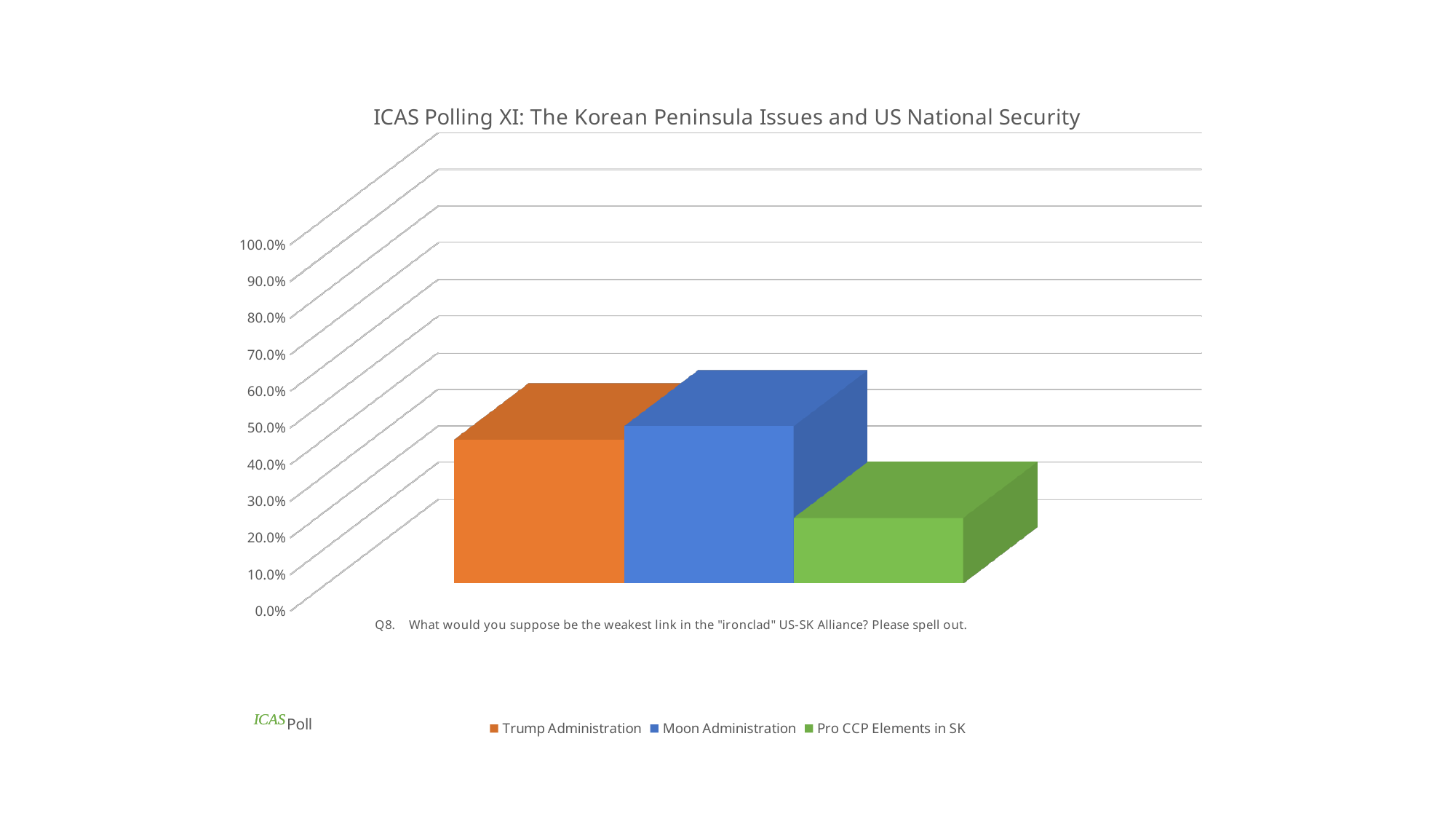
What is the title of the chart? ICAS Polling XI: The Korean Peninsula Issues and US National Security How many series does the legend list? 3 What kind of chart is shown on the slide? bar chart Which series has the lowest value? Pro CCP Elements in SK Is the value for Pro CCP Elements in SK greater or less than 30.0%? less Is the value for Trump Administration greater or less than 20.0%? greater Which is larger, the value for Trump Administration or the value for Pro CCP Elements in SK? Trump Administration Which colour represents the Moon Administration series in the legend? blue Which series has the highest value? Moon Administration Which is larger, the value for Moon Administration or the value for Trump Administration? Moon Administration Is the value for Moon Administration greater or less than 60.0%? less How many bars are plotted in the chart? 3